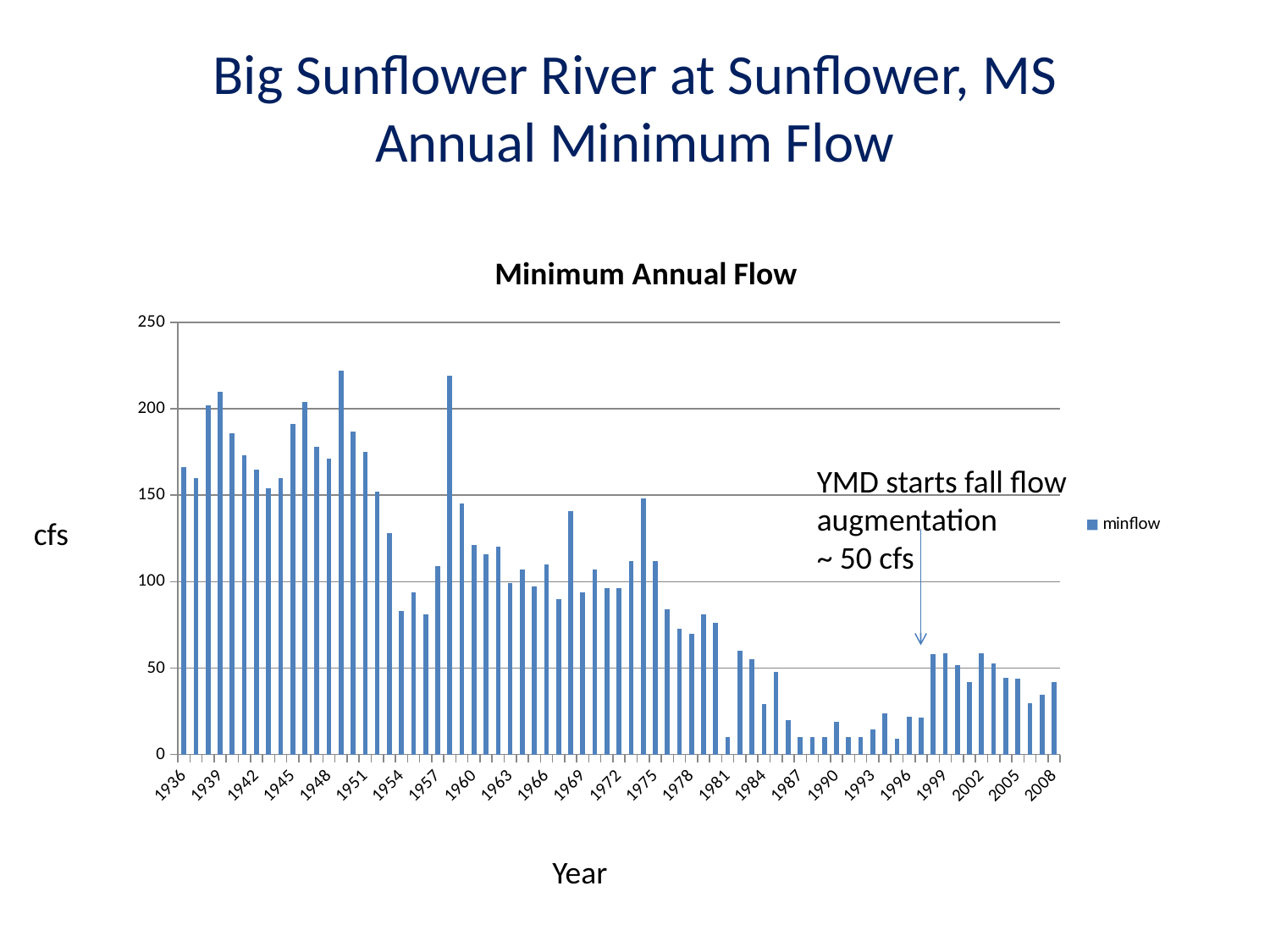
Which year has the larger minimum flow, 1936 or 2008? 1936 Is the value for 1960 greater or less than 100? greater Is the value for 1954 greater or less than 100? less What is the title printed above the chart? Minimum Annual Flow Is the value for 1981 greater or less than 50? less How many series does the chart legend list? 1 Overall, do the minimum flow values rise or fall from 1936 to 2008? fall What is the name of the series shown in the chart legend? minflow What kind of chart is shown on the slide? bar chart